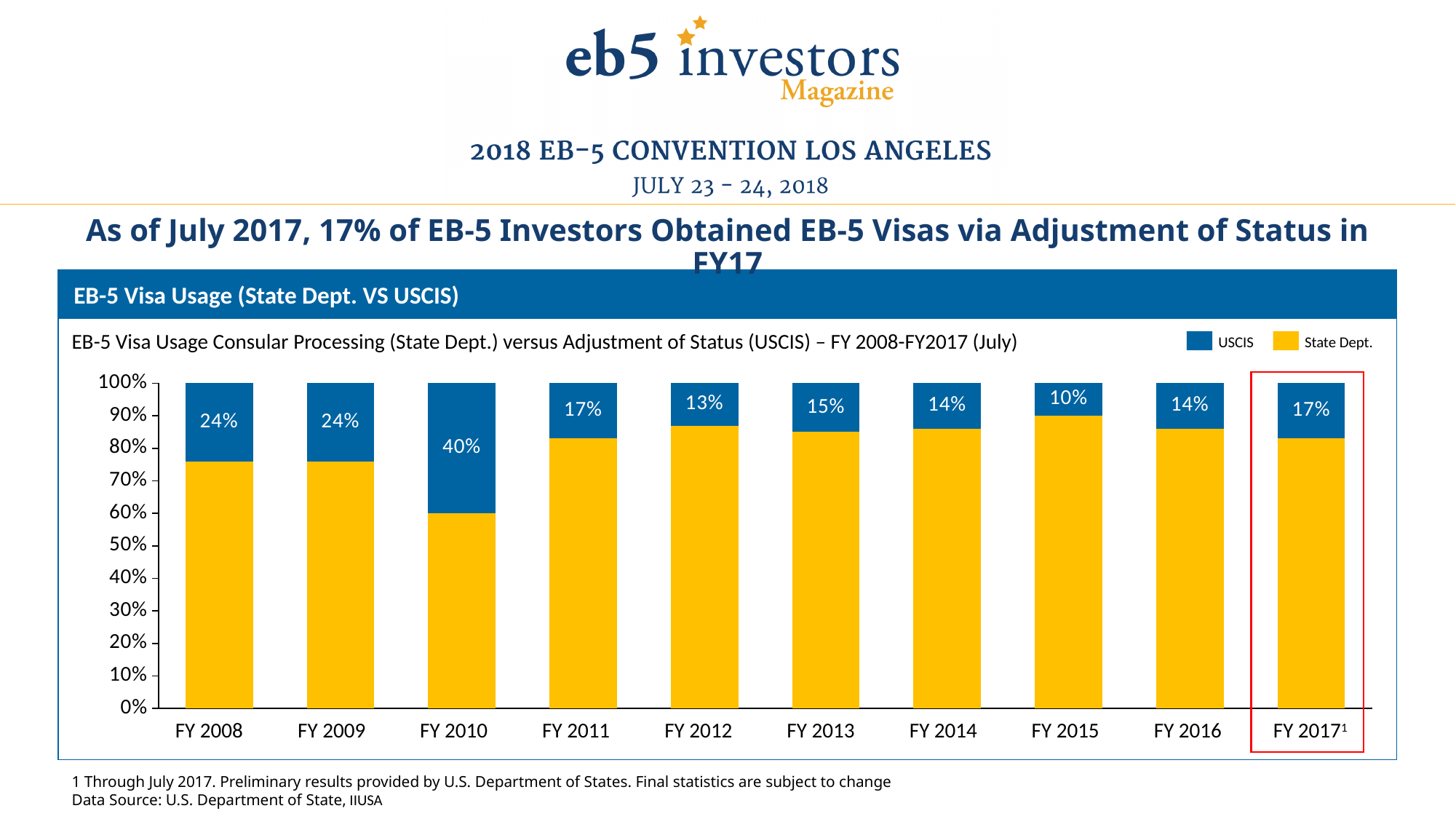
Which fiscal year has the lowest USCIS value? FY 2015 What kind of chart is shown? stacked bar chart How many fiscal years are shown on the x axis? 10 What is the USCIS value for FY 2017? 17% Which fiscal year has the highest USCIS value? FY 2010 What is the USCIS value for FY 2010? 40% What is the difference between the USCIS value for FY 2010 and FY 2015? 30% What is the USCIS value for FY 2015? 10% How many series does the legend list? 2 Which is larger, the USCIS value for FY 2008 or for FY 2011? FY 2008 Which colour represents State Dept. in the chart? yellow Is the State Dept. value for FY 2010 greater or less than 70%? less